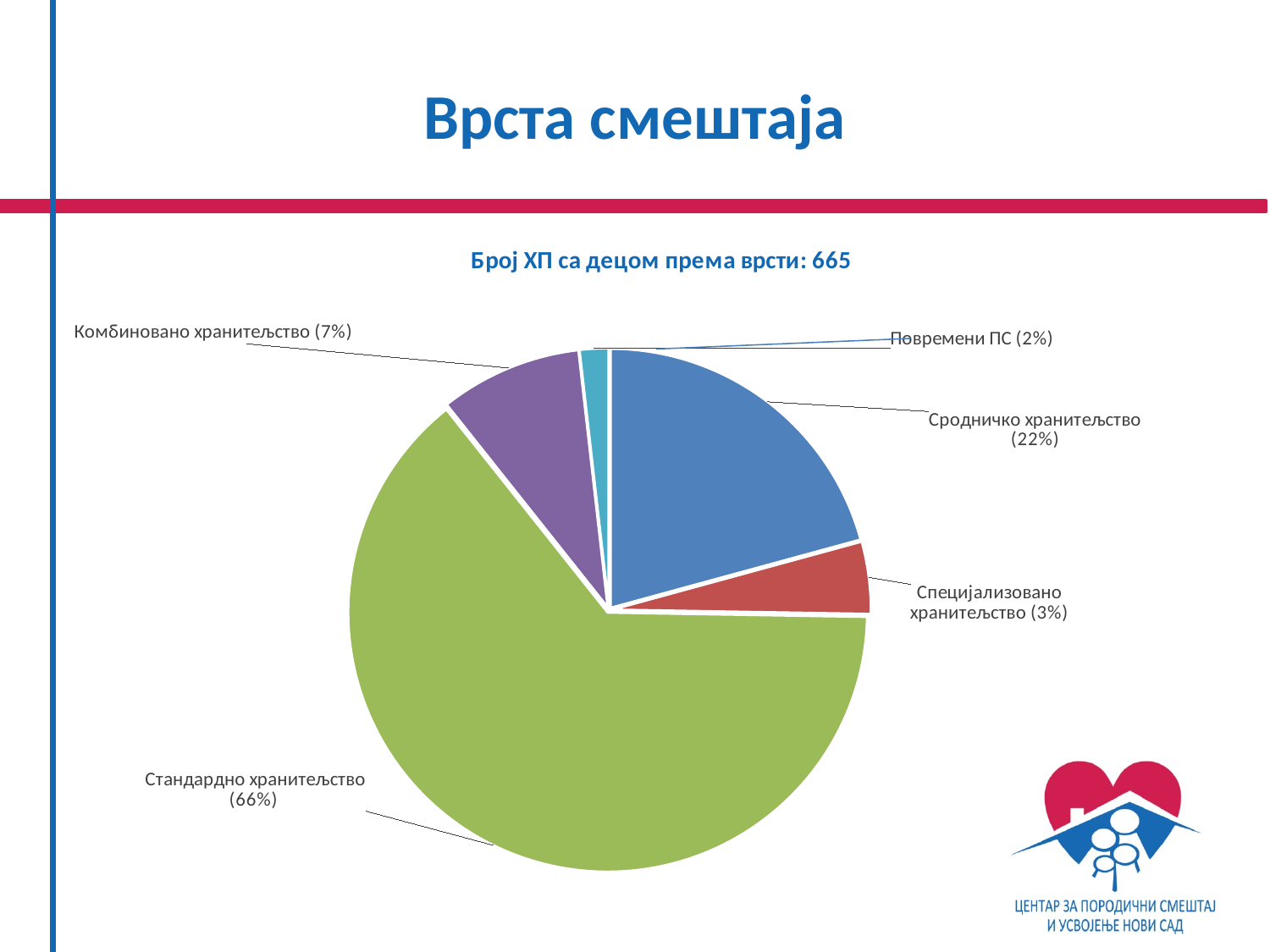
What share of the pie is Специјализовано хранитељство? 3% Which is larger, the share for Комбиновано хранитељство or the share for Специјализовано хранитељство? Комбиновано хранитељство How many slices does the pie chart have? 5 What share of the pie is Сродничко хранитељство? 22% Which category has the largest share of the pie? Стандардно хранитељство What share of the pie is Повремени ПС? 2% What is the difference in percentage points between Стандардно хранитељство and Сродничко хранитељство? 44 What kind of chart is shown on the slide? pie chart Which category has the smallest share of the pie? Повремени ПС What is the title of the chart? Број ХП са децом према врсти: 665